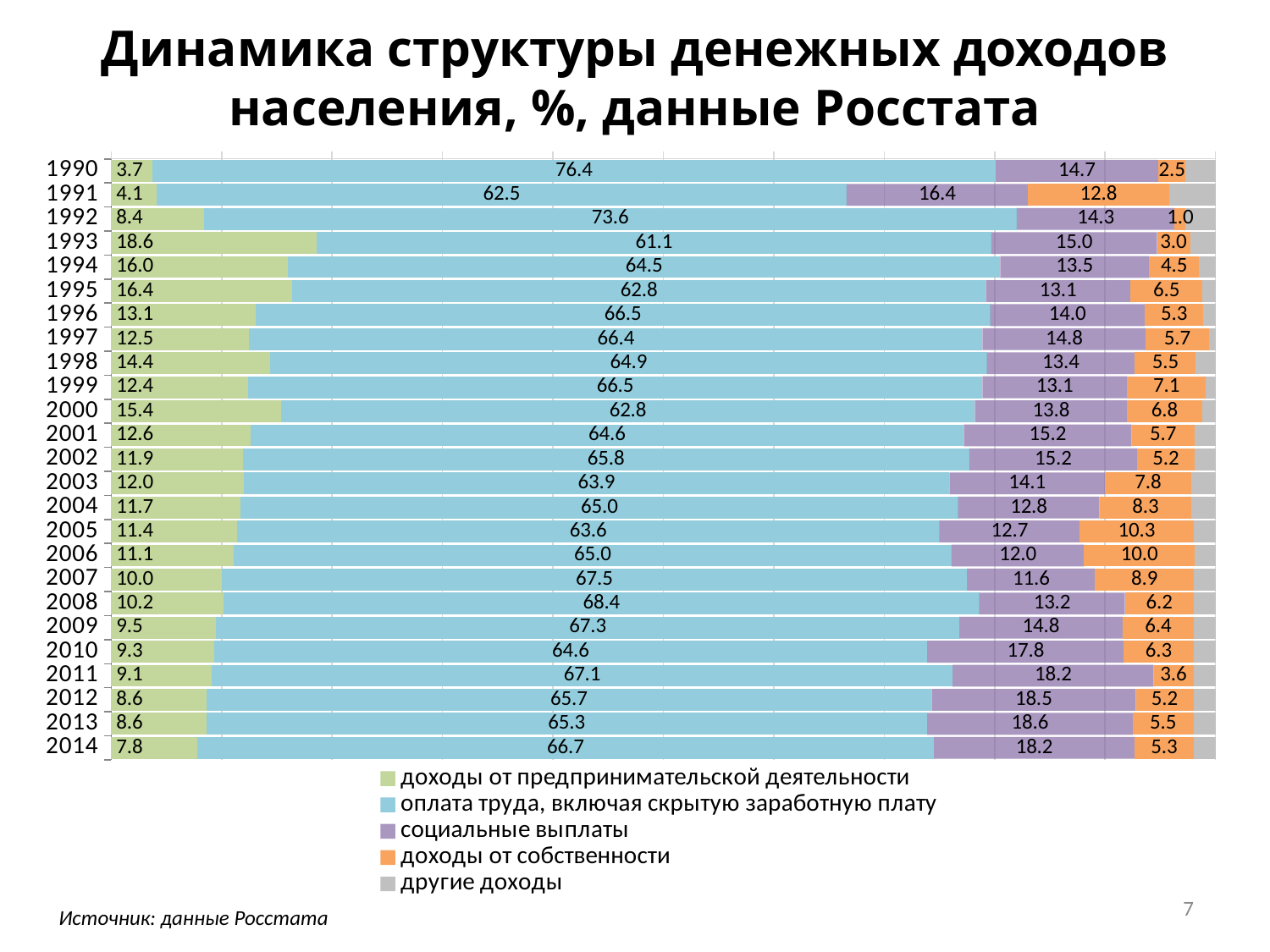
Which year has the larger value for социальные выплаты, 2009 or 2010? 2010 In which year is the value for доходы от предпринимательской деятельности the highest? 1993 By how much is the value for оплата труда, включая скрытую заработную плату in 1990 larger than in 2014? 9.7 How many years are shown on the chart? 25 What is the value for социальные выплаты in 2014? 18.2 In which year is the value for оплата труда, включая скрытую заработную плату the lowest? 1993 What kind of chart is shown on the slide? Stacked bar chart How many series does the legend list? 5 What is the value for доходы от собственности in 1991? 12.8 What is the value for доходы от предпринимательской деятельности in 1993? 18.6 What is the value for оплата труда, включая скрытую заработную плату in 1990? 76.4 In which year is the value for доходы от собственности the highest? 1991